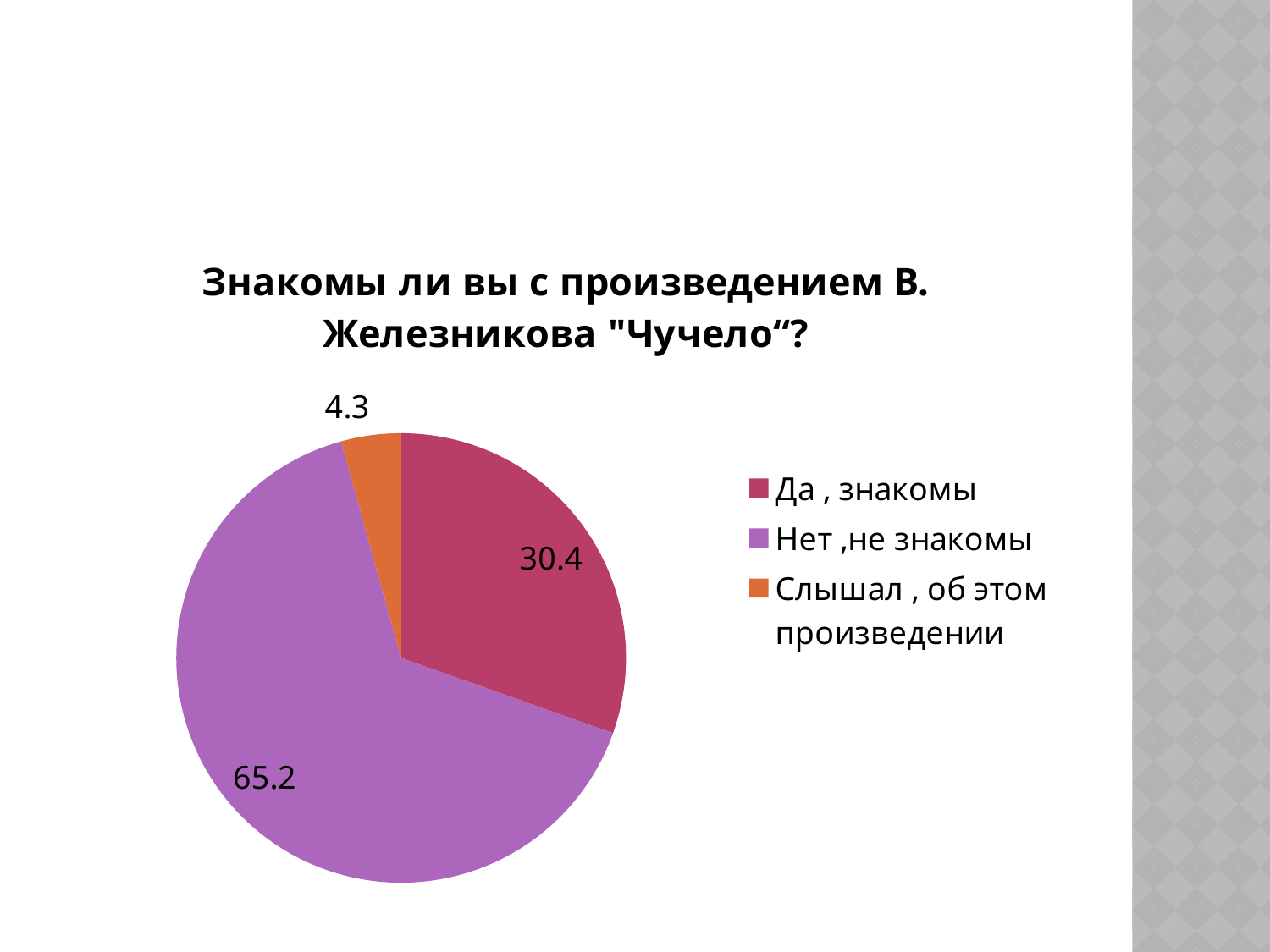
What is the value for "Слышал , об этом произведении"? 4.3 Which is larger: the value for "Да , знакомы" or the value for "Слышал , об этом произведении"? Да , знакомы How many entries does the legend list? 3 How many slices does the pie chart have? 3 What type of chart is shown on the slide? pie chart Which category has the smallest slice? Слышал , об этом произведении What is the value for "Нет ,не знакомы"? 65.2 Which category has the largest slice? Нет ,не знакомы What is the title of the chart? Знакомы ли вы с произведением В. Железникова "Чучело"? What colour is the slice for "Нет ,не знакомы"? purple What is the value for "Да , знакомы"? 30.4 What is the difference between the values for "Нет ,не знакомы" and "Да , знакомы"? 34.8